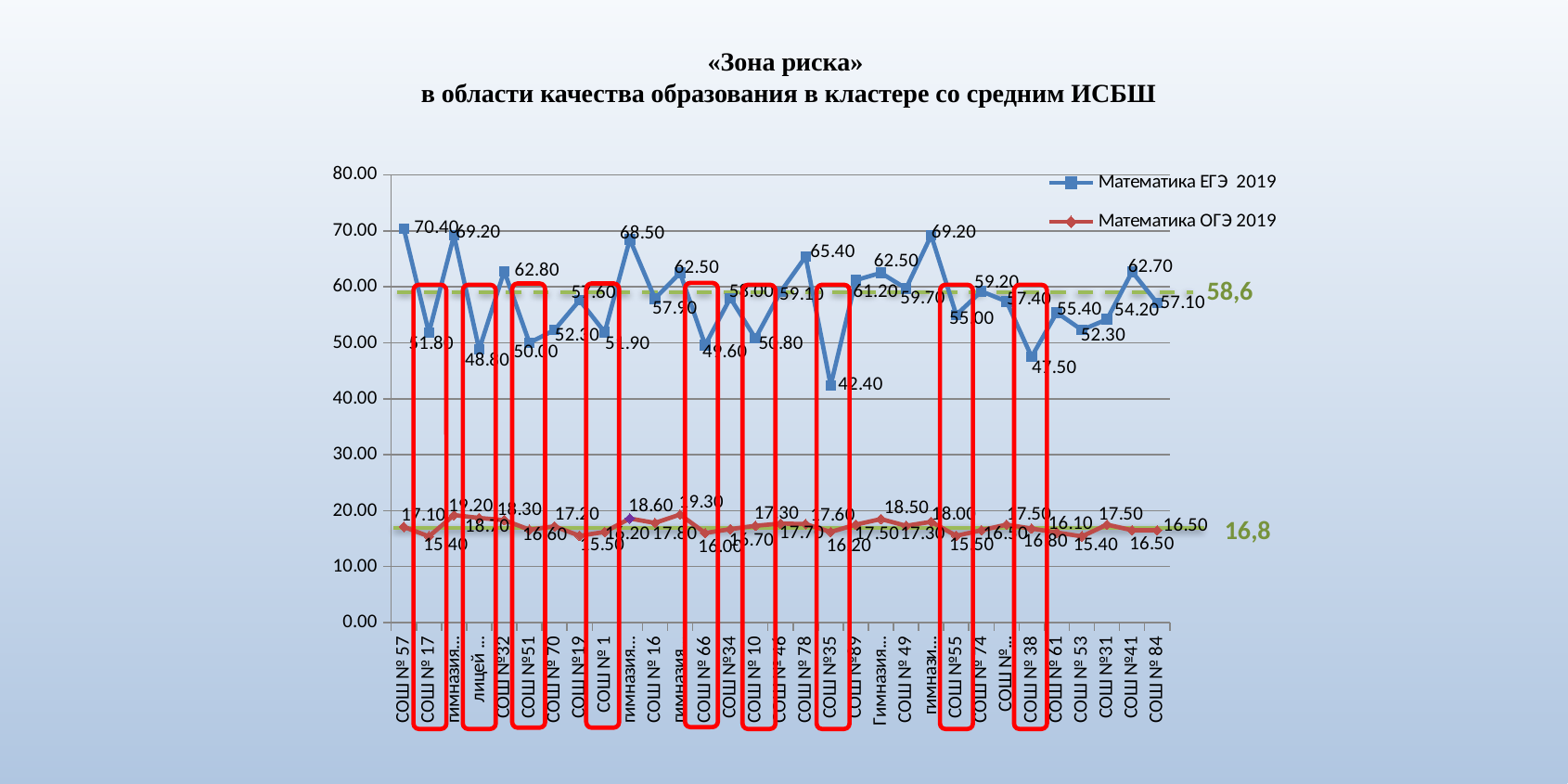
What is the Математика ЕГЭ 2019 value for СОШ №35? 42.40 Which has the larger Математика ЕГЭ 2019 value, СОШ №41 or СОШ № 84? СОШ №41 Which school has the highest Математика ЕГЭ 2019 value? СОШ № 57 What value is labelled on the dashed green reference line for the Математика ЕГЭ 2019 series? 58,6 How many series does the legend list? 2 Is the Математика ЕГЭ 2019 value for СОШ № 38 greater or less than 50.00? less What is the difference between the Математика ЕГЭ 2019 values for СОШ № 57 and СОШ № 17? 18.60 What is the Математика ЕГЭ 2019 value for СОШ № 38? 47.50 What kind of chart is shown on the slide? line chart What is the Математика ОГЭ 2019 value for СОШ № 17? 15.40 Which school has the lowest Математика ЕГЭ 2019 value? СОШ №35 What is the Математика ЕГЭ 2019 value for СОШ № 57? 70.40